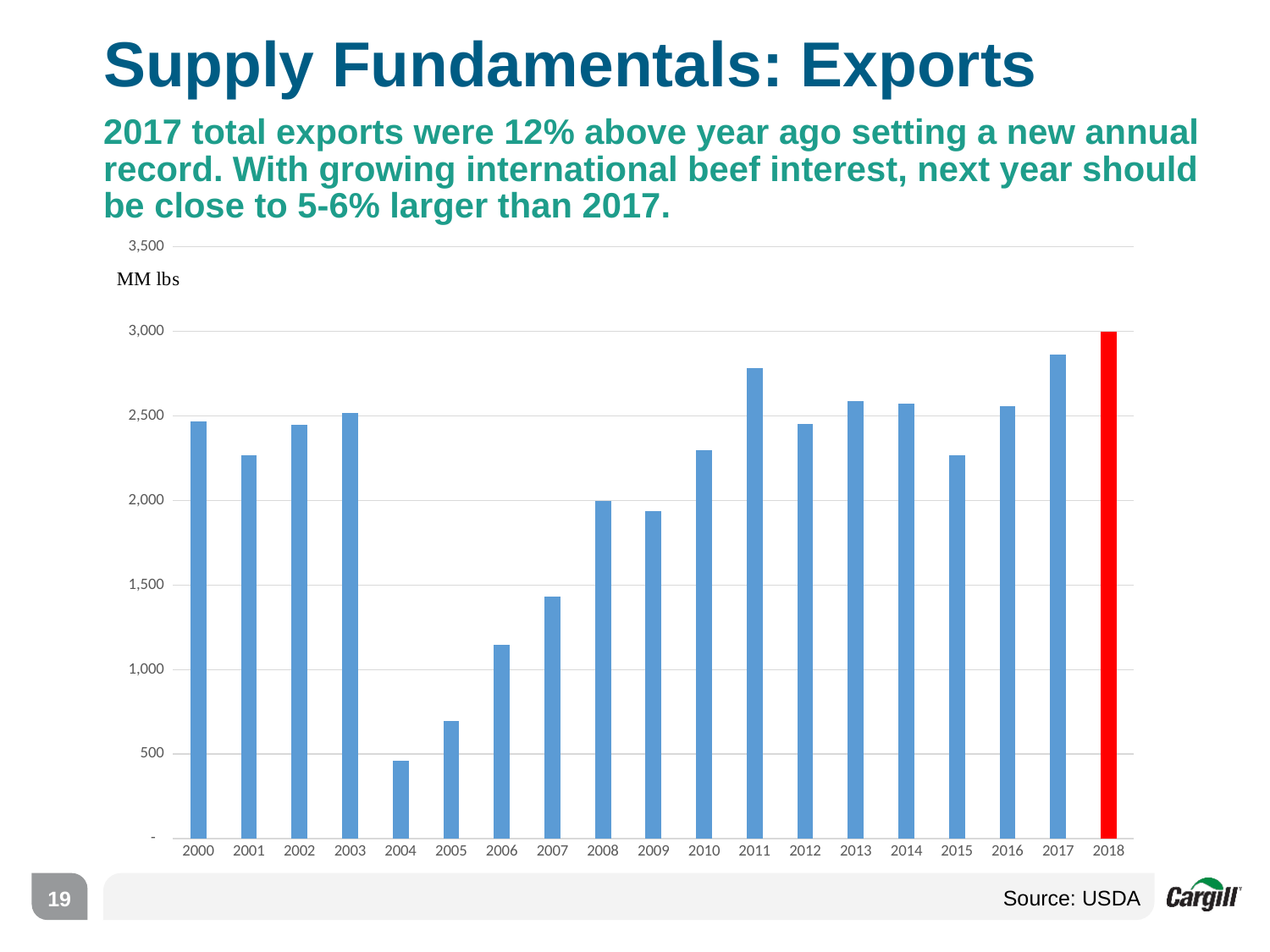
Is the value for 2009 greater or less than 2,000? less What colour is the bar for 2018? red Which year has the larger value, 2011 or 2013? 2011 Do the values rise or fall from 2004 to 2008? rise Which year has the larger value, 2010 or 2012? 2012 Which year has the highest bar in the chart? 2018 Is the value for 2004 greater or less than 500? less Which year has the lowest bar in the chart? 2004 What kind of chart is shown on the slide? bar chart Is the value for 2011 greater or less than 2,500? greater How many years are plotted on the x axis of the chart? 19